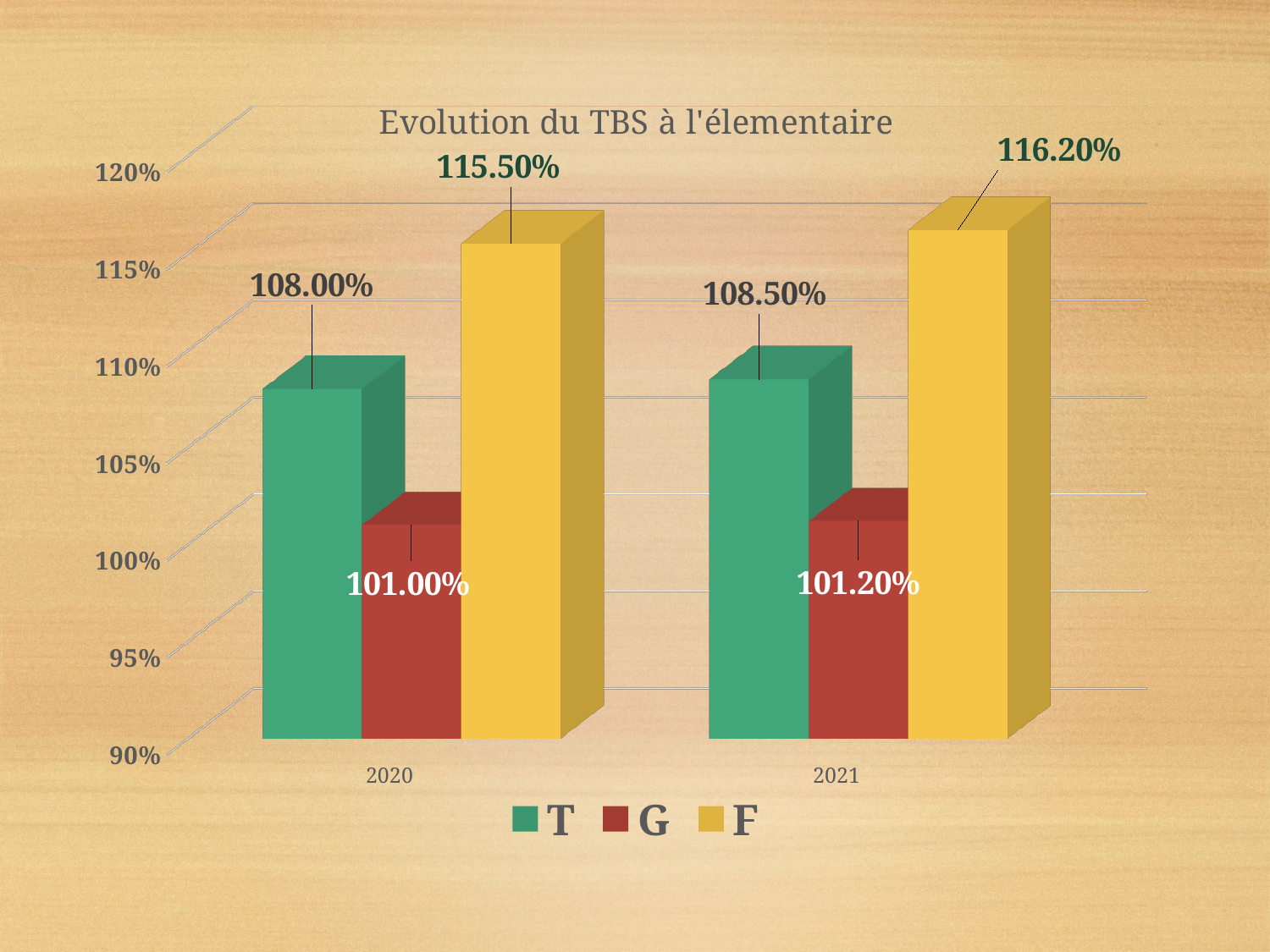
What kind of chart is shown on the slide? bar chart Which series has the highest value in 2021? F What is the value for G in 2021? 101.20% What is the title of the chart? Evolution du TBS à l'élementaire Which is larger, the T value in 2020 or the T value in 2021? 2021 What is the value for F in 2021? 116.20% How many series does the legend list? 3 What is the value for T in 2020? 108.00% Which series has the lowest value in 2020? G How many categories are shown on the x axis? 2 Does the value for G rise or fall from 2020 to 2021? rise What is the difference between the F value in 2021 and the F value in 2020? 0.70%